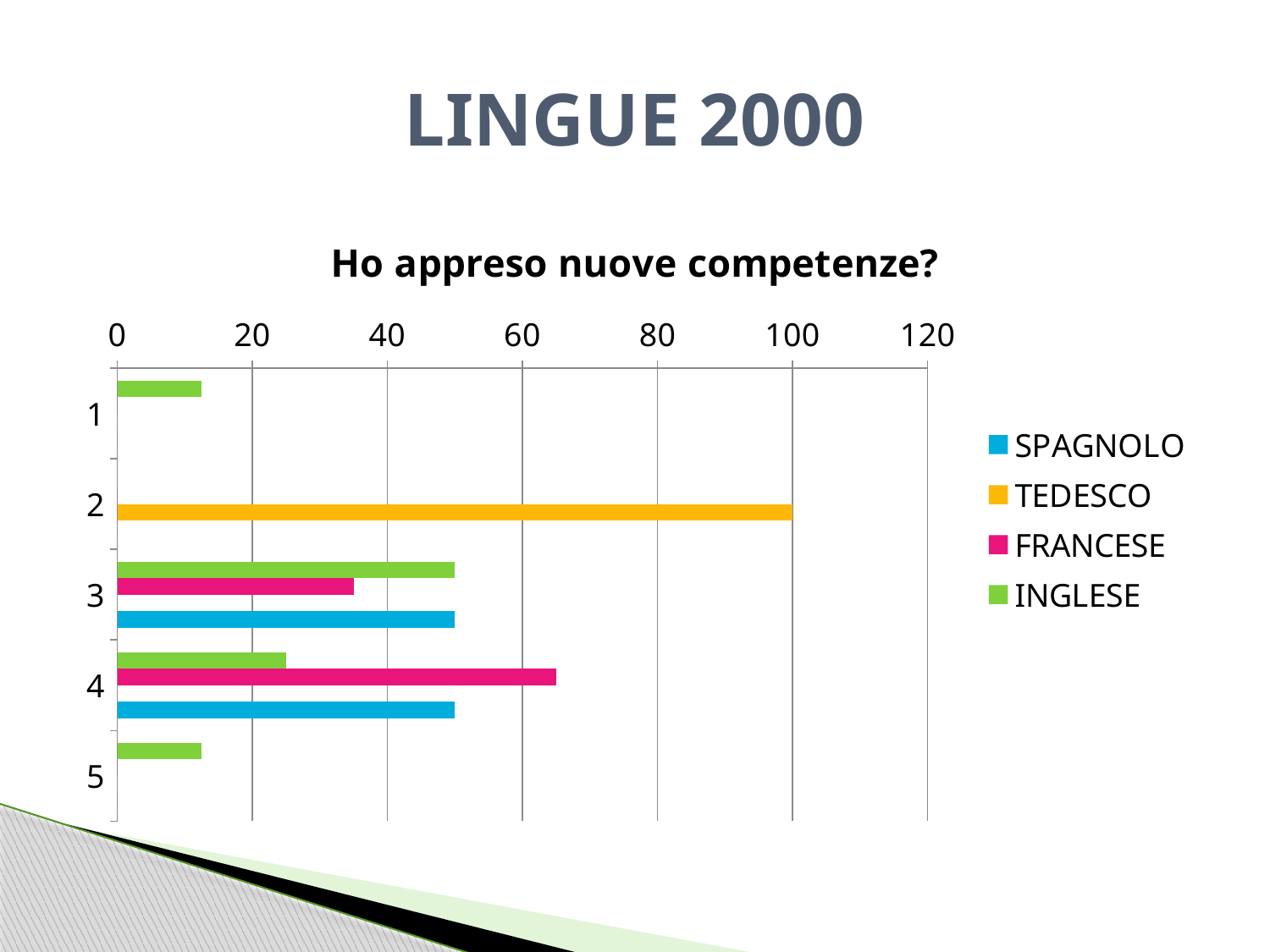
What is the title of the chart? Ho appreso nuove competenze? In category 4, which is larger, the value for FRANCESE or the value for SPAGNOLO? FRANCESE Is the value for INGLESE in category 4 greater or less than 20? greater How many categories are shown on the vertical axis? 5 How many series does the legend list? 4 In category 3, which is larger, the value for INGLESE or the value for FRANCESE? INGLESE Is the value for FRANCESE in category 4 greater or less than 60? greater Is the value for FRANCESE in category 3 greater or less than 40? less What is the value of TEDESCO for category 2? 100 Which series has the longest bar in the chart? TEDESCO What kind of chart is shown on the slide? bar chart